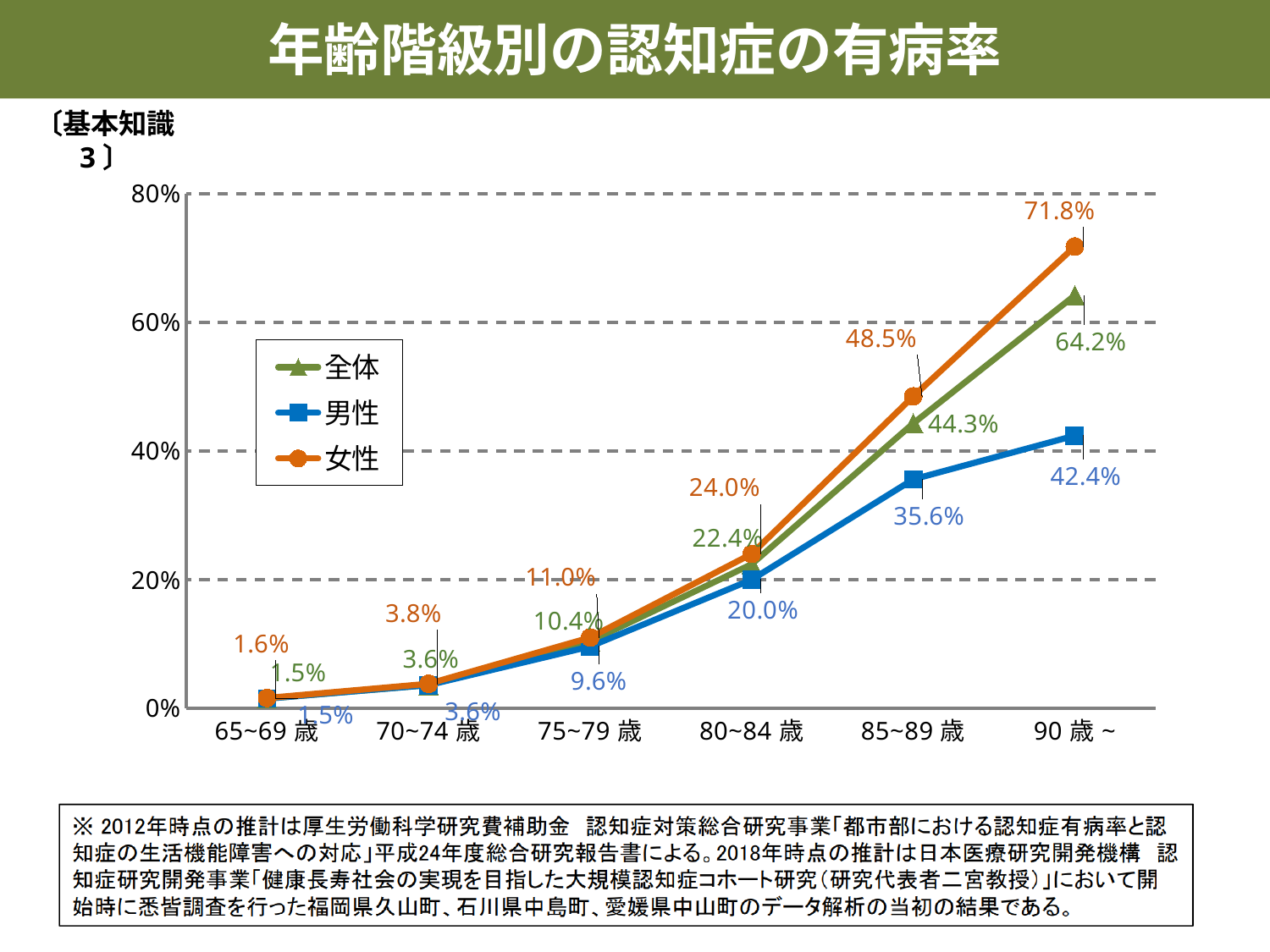
What is the value for 女性 in the 90歳~ age group? 71.8% What is the value for 男性 in the 85~89歳 age group? 35.6% What is the value for 女性 in the 75~79歳 age group? 11.0% Do the values for 全体 rise or fall as age increases along the x axis? rise How many age categories are shown on the x axis? 6 Which age group has the lowest value for 女性? 65~69歳 What is the value for 全体 in the 80~84歳 age group? 22.4% Which age group has the highest value for 男性? 90歳~ How many series does the legend list? 3 What type of chart is shown on the slide? line chart In the 85~89歳 age group, which is larger, the value for 女性 or the value for 男性? 女性 What is the difference between the 女性 and 男性 values in the 90歳~ age group? 29.4%